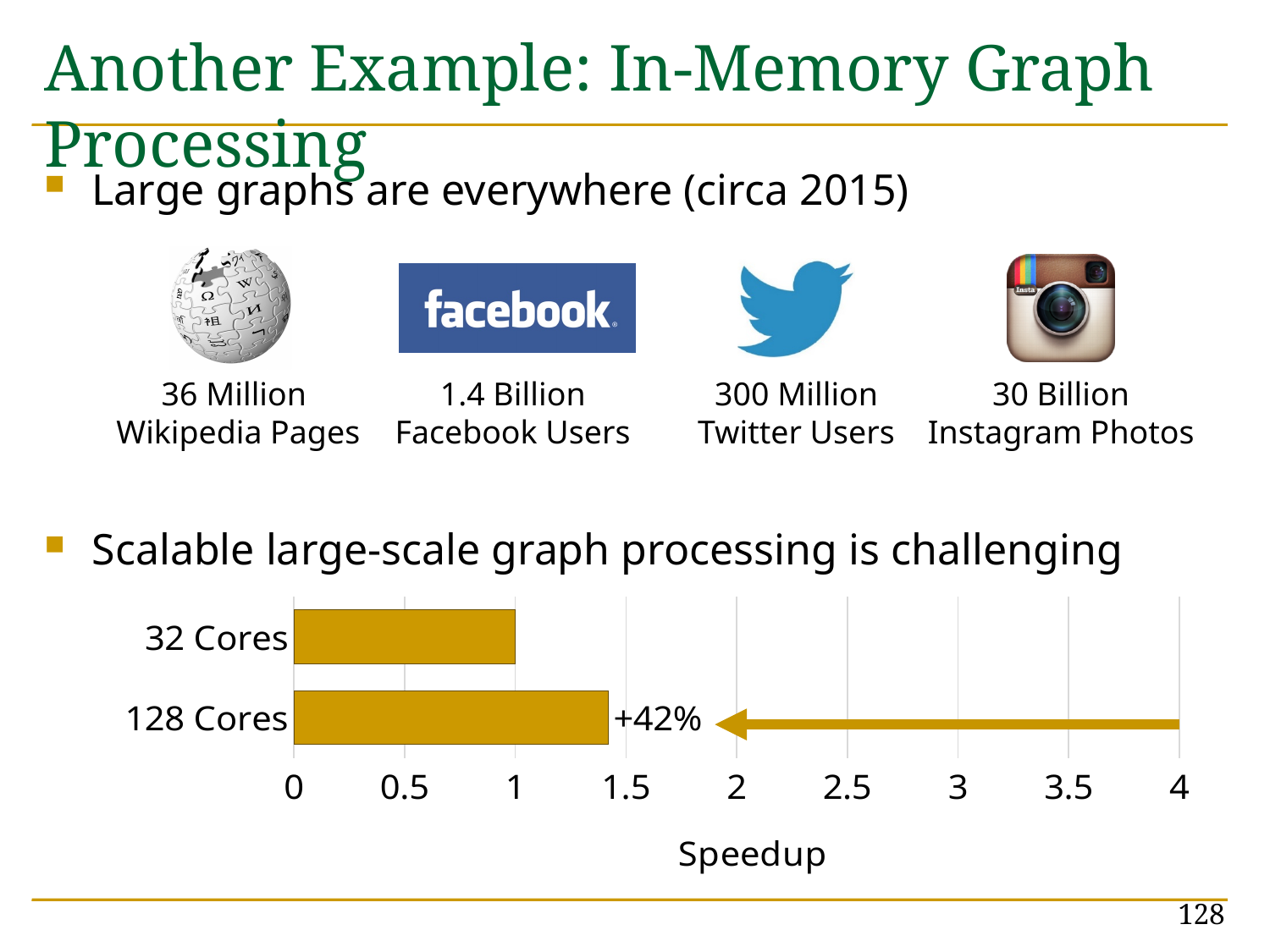
What is the maximum value shown on the x axis of the chart? 4 Which category has the highest speedup? 128 Cores What kind of chart is shown on the slide? bar chart How many categories does the bar chart show? 2 Which category has the lowest speedup? 32 Cores Is the speedup for 128 Cores greater or less than 1? greater What is the title of the x axis of the chart? Speedup What is the speedup value for 32 Cores? 1 Which is larger, the speedup for 128 Cores or for 32 Cores? 128 Cores What percentage improvement is annotated next to the 128 Cores bar? +42% Is the speedup for 128 Cores greater or less than 2? less Is the speedup for 128 Cores greater or less than 1.5? less